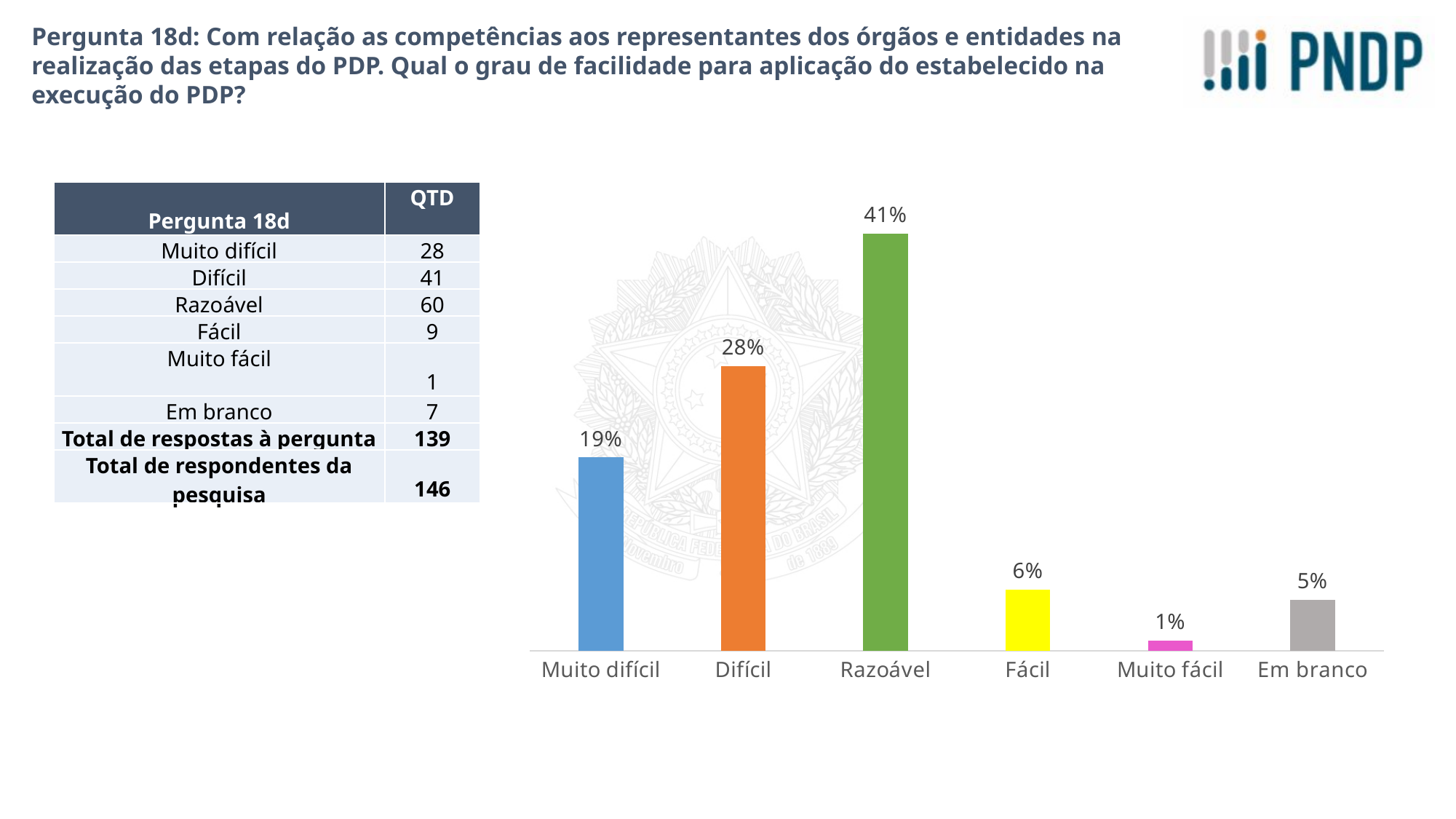
What is the difference in percentage points between Difícil and Muito difícil in the bar chart? 9% What percentage is shown for Muito difícil in the bar chart? 19% What is the difference in percentage points between Razoável and Difícil in the bar chart? 13% What percentage is shown for Razoável in the bar chart? 41% What percentage is shown for Em branco in the bar chart? 5% How many categories are shown on the x axis of the bar chart? 6 What colour is the bar for Razoável in the chart? Green Which category has the highest value in the bar chart? Razoável What colour is the bar for Fácil in the chart? Yellow Which category has the lowest value in the bar chart? Muito fácil Which is larger in the bar chart, Fácil or Em branco? Fácil What kind of chart is shown on the slide? Bar chart